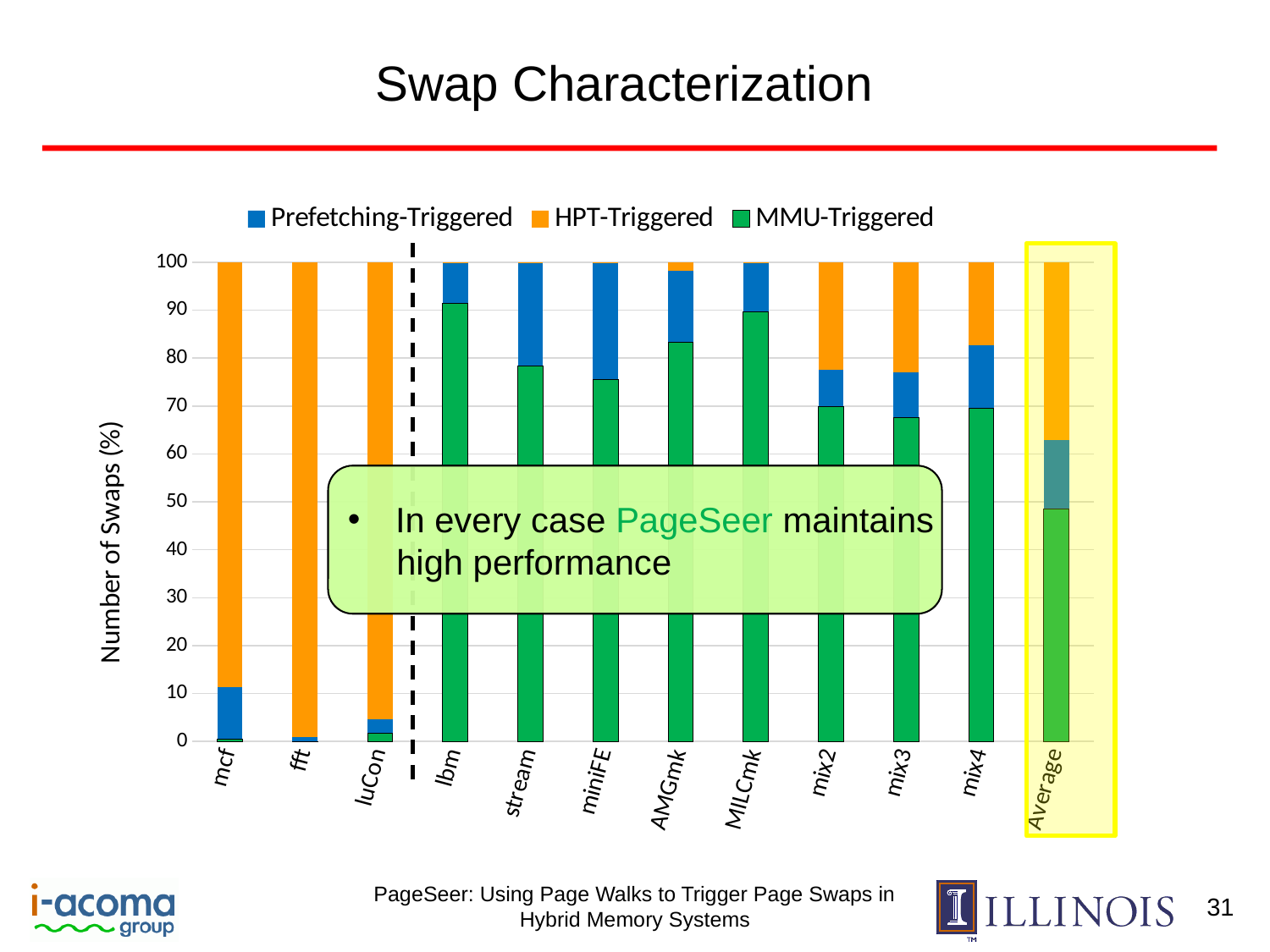
How many categories are shown on the x axis? 12 Is the MMU-Triggered value for mcf greater or less than 10? less How many series does the legend list? 3 What is the total height of the stacked bar for Average? 100 Which has a larger MMU-Triggered value, lbm or stream? lbm Is the MMU-Triggered value for lbm greater or less than 80? greater What kind of chart is shown on the slide? Stacked bar chart Is the HPT-Triggered value for mcf greater or less than 80? greater What is the title of the slide containing the chart? Swap Characterization What is the label of the y axis? Number of Swaps (%) Which has a larger HPT-Triggered value, fft or mix2? fft